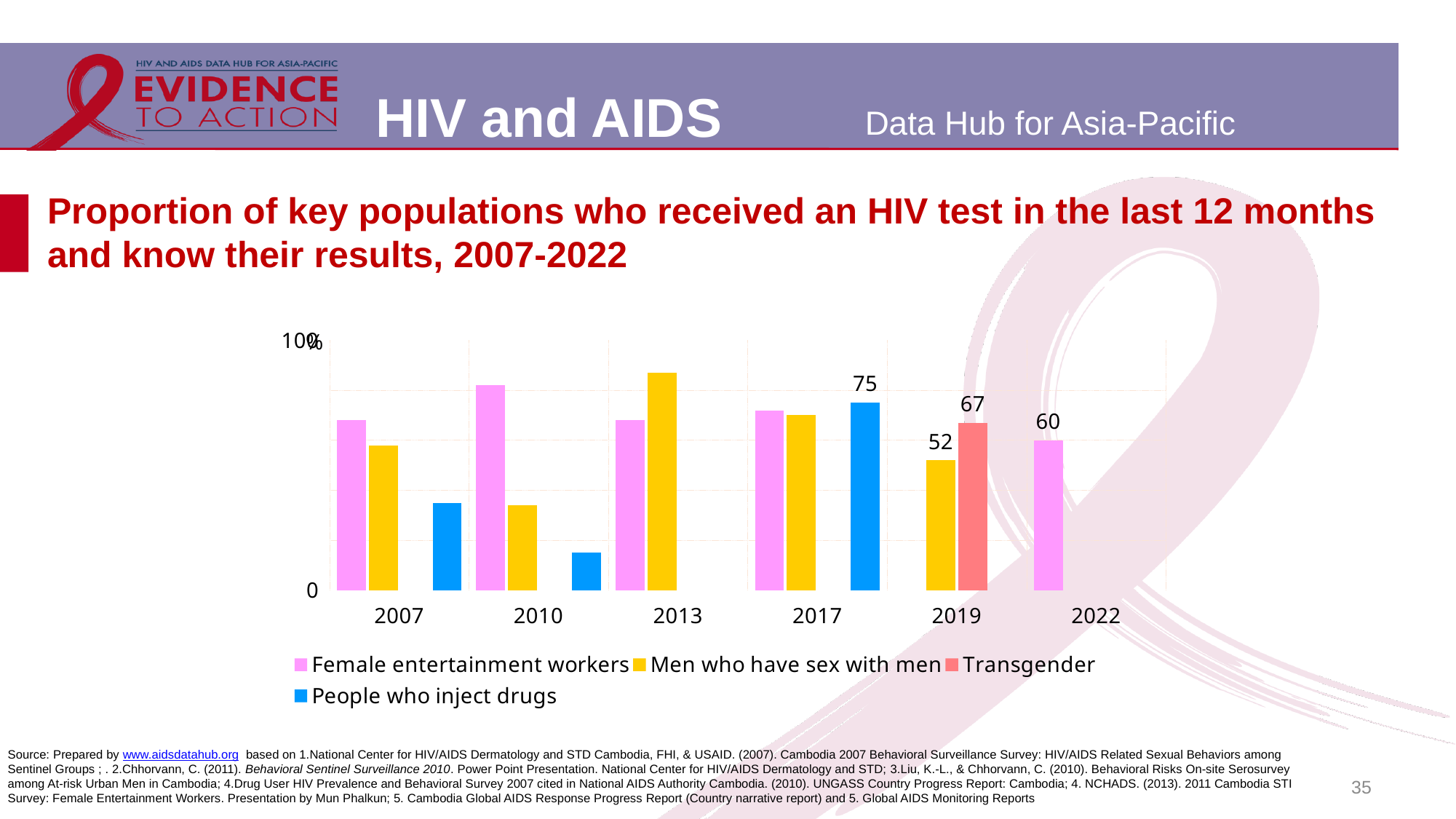
In 2019, which is larger: the value for Transgender or for Men who have sex with men? Transgender What is the value for Female entertainment workers in 2022? 60 What is the value for Men who have sex with men in 2019? 52 How many series does the legend list? 4 Which series is shown in blue in the legend? People who inject drugs In 2019, what is the difference between the Transgender value and the Men who have sex with men value? 15 What kind of chart is shown on the slide? Bar chart What is the value for Transgender in 2019? 67 How many years are shown on the x axis? 6 In 2010, which key population has the highest value? Female entertainment workers In 2010, which key population has the lowest value? People who inject drugs What is the value for People who inject drugs in 2017? 75